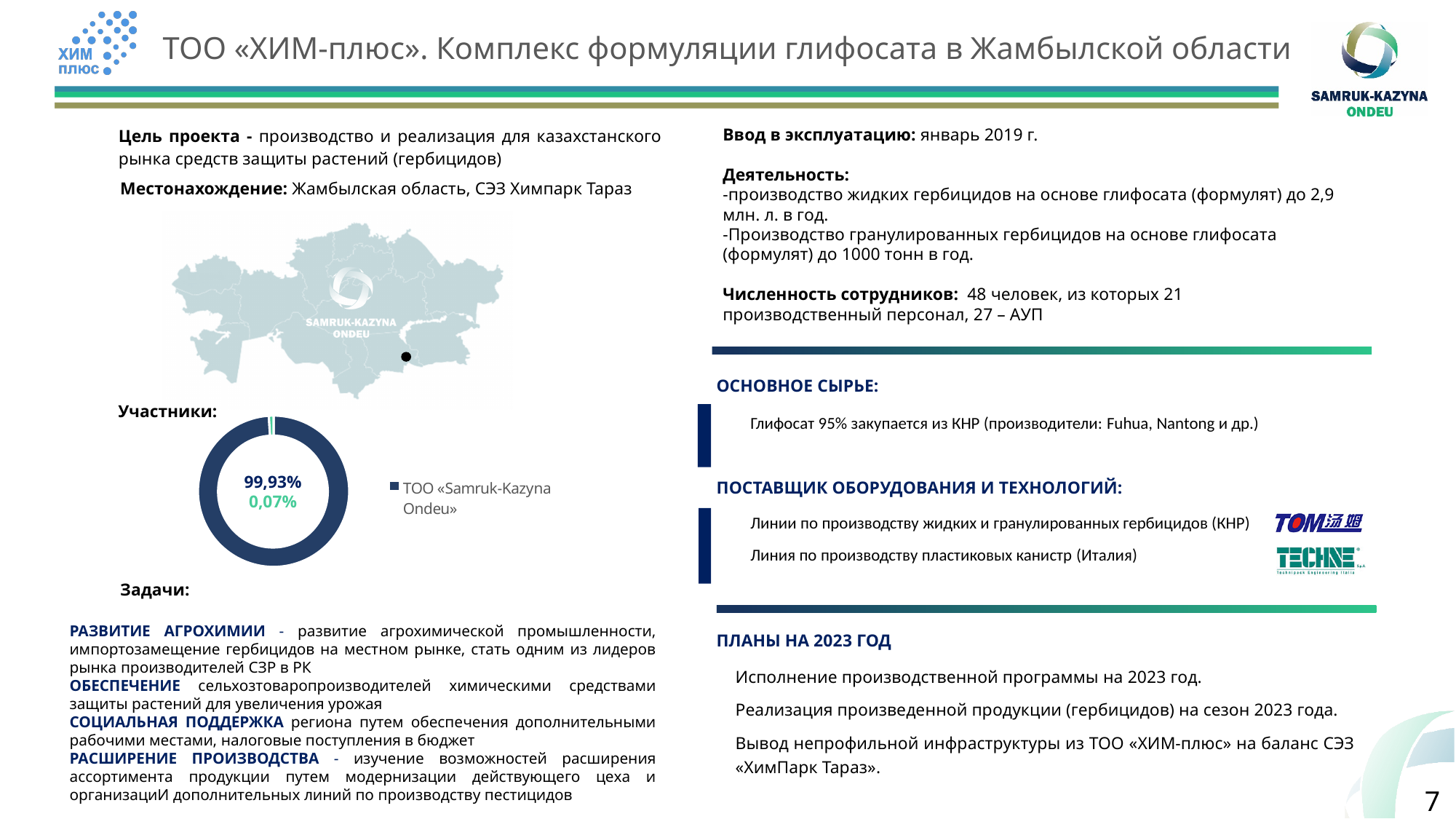
In the «Участники:» chart, what is the value of the largest slice? 99,93% In the «Участники:» chart, what is the value of the smallest slice? 0,07% In the «Участники:» chart, what is the difference between the two slice values? 99,86% What is the only legend entry shown next to the «Участники:» chart? ТОО «Samruk-Kazyna Ondeu» In the «Участники:» chart, which slice is larger: the one labelled 99,93% or the one labelled 0,07%? 99,93% What kind of chart is shown under the heading «Участники:»? pie chart (donut) In the «Участники:» chart, what do the two slice values add up to? 100% How many entries does the legend of the «Участники:» chart list? 1 How many slices does the «Участники:» chart have? 2 What heading appears directly above the donut chart on the slide? Участники: In the «Участники:» chart, what share is shown for ТОО «Samruk-Kazyna Ondeu»? 99,93%